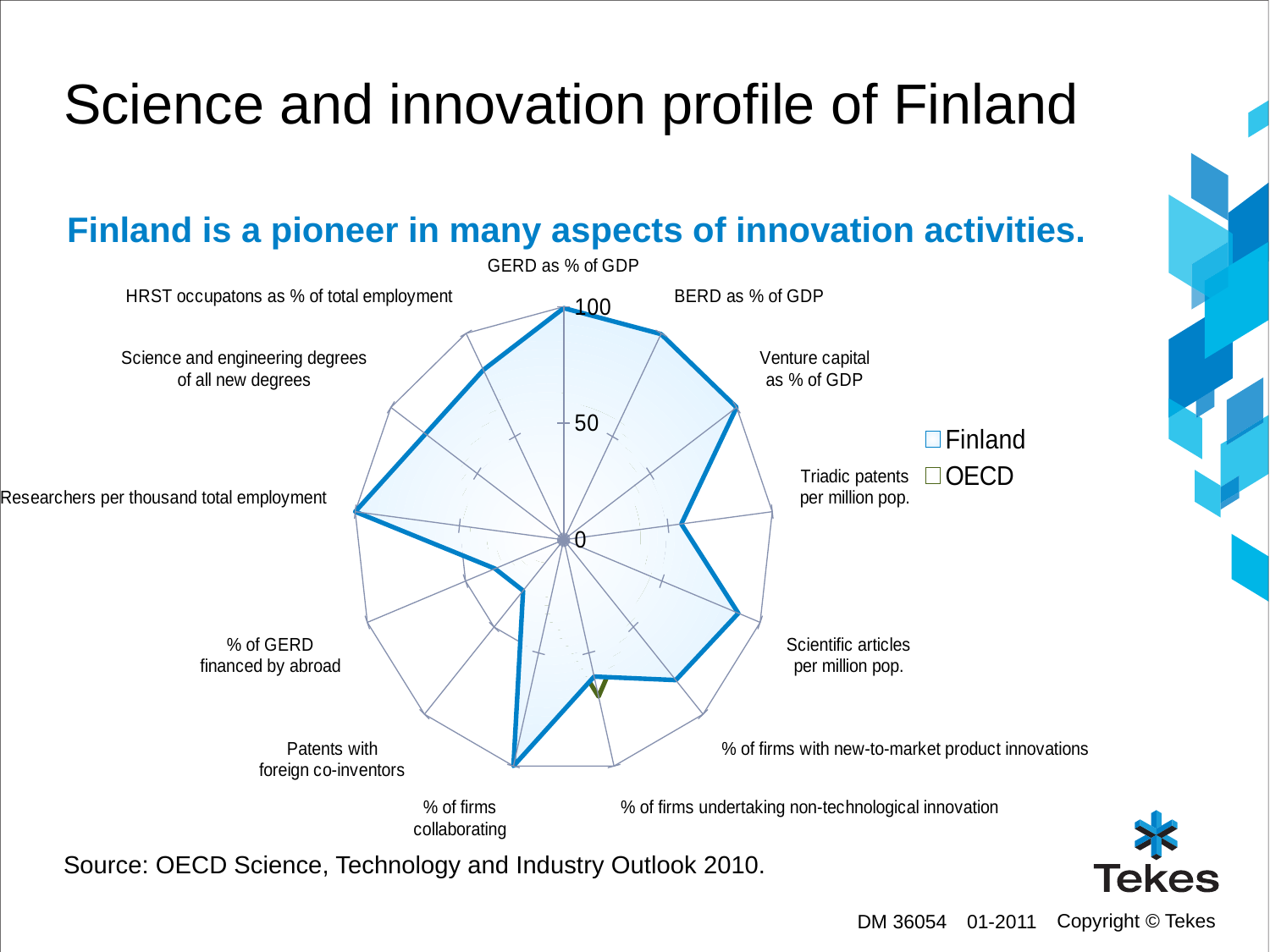
Is Finland's value for Researchers per thousand total employment greater or less than 50? greater What is the maximum value shown on the radar chart's scale? 100 Is Finland's value for Scientific articles per million pop. greater or less than 50? greater Which two series are listed in the chart legend? Finland and OECD Is Finland's value for GERD as % of GDP greater or less than 50? greater How many indicator axes does the radar chart have? 13 How many series does the chart legend list? 2 Which is larger for Finland: GERD as % of GDP or % of firms with new-to-market product innovations? GERD as % of GDP What kind of chart is shown on the slide? Radar chart